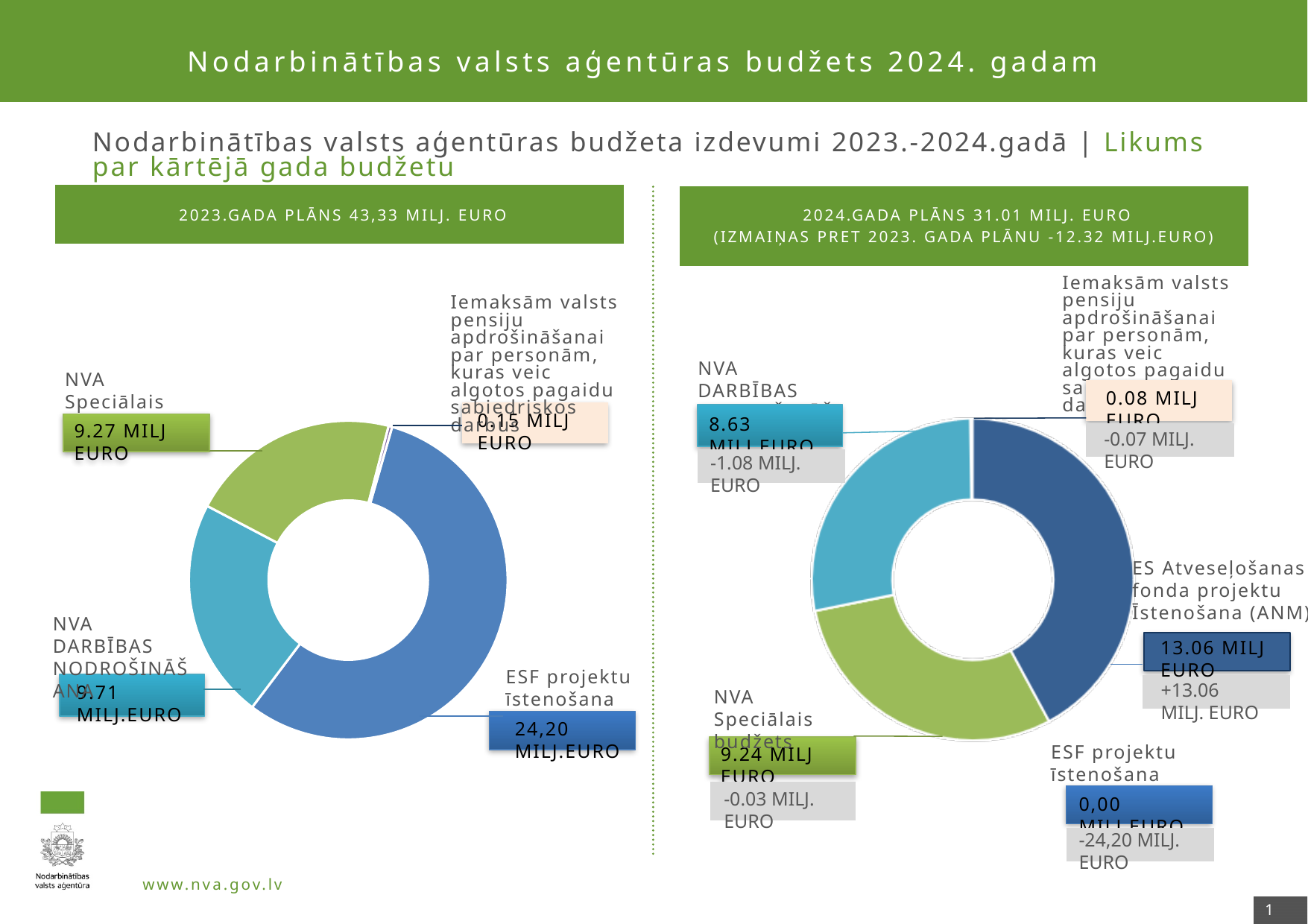
How many categories are shown on the 2024 chart (right)? 5 On the 2024 chart (right), what is the value for ESF projektu īstenošana? 0,00 MILJ.EURO On the 2024 chart (right), what is the difference between ES Atveseļošanas fonda projektu īstenošana (ANM) and NVA Speciālais budžets? 3.82 MILJ EURO On the 2023 chart (left), which category has the largest value? ESF projektu īstenošana On the 2023 chart (left), which is larger: NVA darbības nodrošināšana or NVA Speciālais budžets? NVA darbības nodrošināšana What kind of chart is used on the left side of the slide for the 2023 plan? Donut (pie) chart On the 2023 chart (left), what is the value for ESF projektu īstenošana? 24,20 MILJ.EURO On the 2024 chart (right), which category has the largest value? ES Atveseļošanas fonda projektu īstenošana (ANM) On the 2024 chart (right), what is the change versus the 2023 plan shown for NVA darbības nodrošināšana? -1.08 MILJ. EURO On the 2023 chart (left), which category has the smallest value? Iemaksām valsts pensiju apdrošināšanai par personām, kuras veic algotos pagaidu sabiedriskos darbus On the 2023 chart (left), what is the value for NVA Speciālais budžets? 9.27 MILJ EURO On the 2024 chart (right), what is the value for ES Atveseļošanas fonda projektu īstenošana (ANM)? 13.06 MILJ EURO